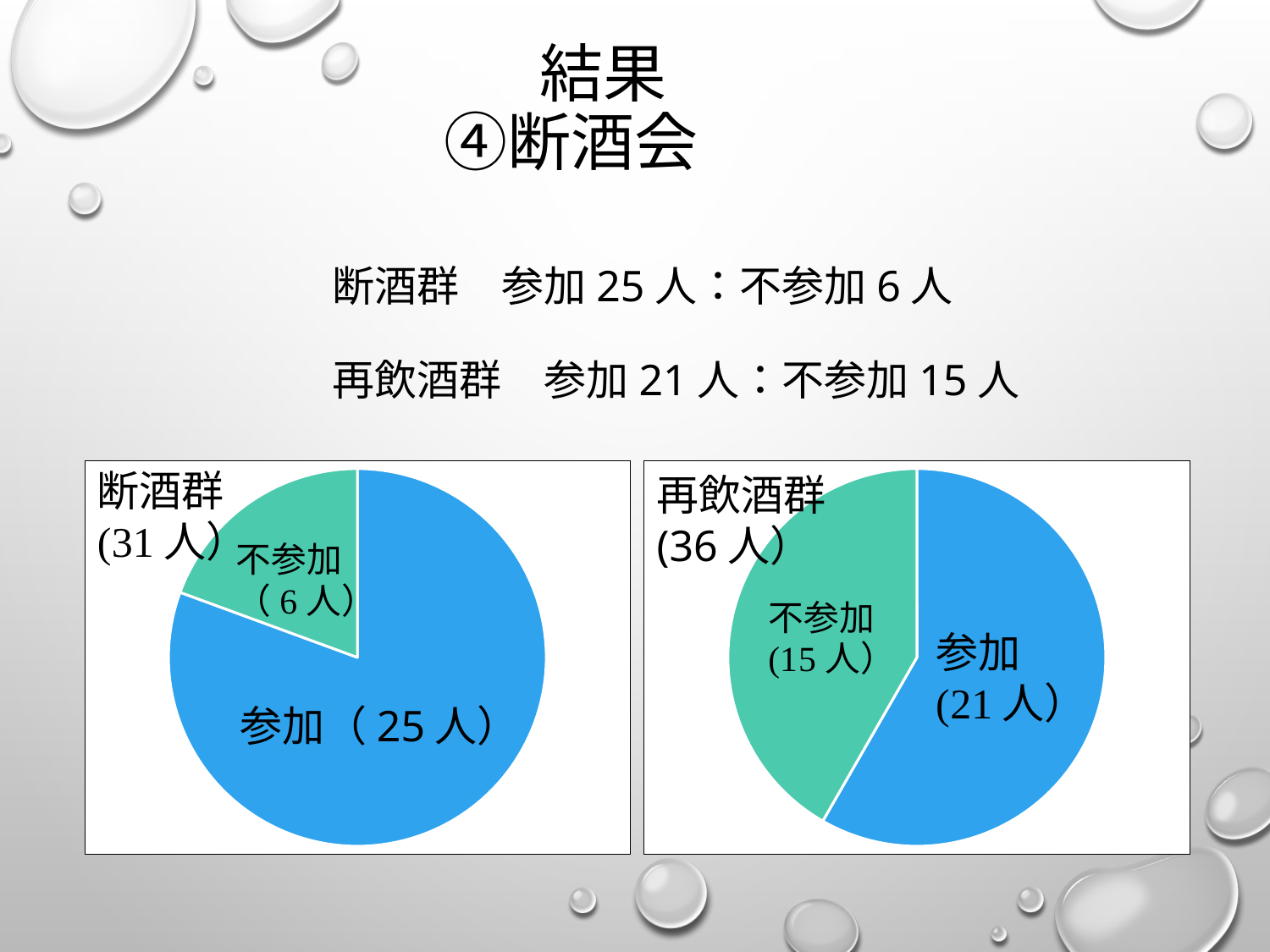
In the left pie chart (断酒群), how many people are in the 不参加 slice? 6人 In the left pie chart (断酒群), which slice is the largest? 参加 In the left pie chart (断酒群), how many people are in the 参加 slice? 25人 In the right pie chart (再飲酒群), what is the difference between the 参加 and 不参加 counts? 6人 In the right pie chart (再飲酒群), how many people are in the 参加 slice? 21人 Is the 参加 count larger in the left pie chart (断酒群) or the right pie chart (再飲酒群)? 断酒群 What total number of people is shown in the label of the right pie chart (再飲酒群)? 36人 What kind of chart is used on the left for 断酒群? Pie chart In the left pie chart (断酒群), what is the difference between the 参加 and 不参加 counts? 19人 How many slices does the right pie chart (再飲酒群) have? 2 In the right pie chart (再飲酒群), how many people are in the 不参加 slice? 15人 In the right pie chart (再飲酒群), which slice is the smallest? 不参加